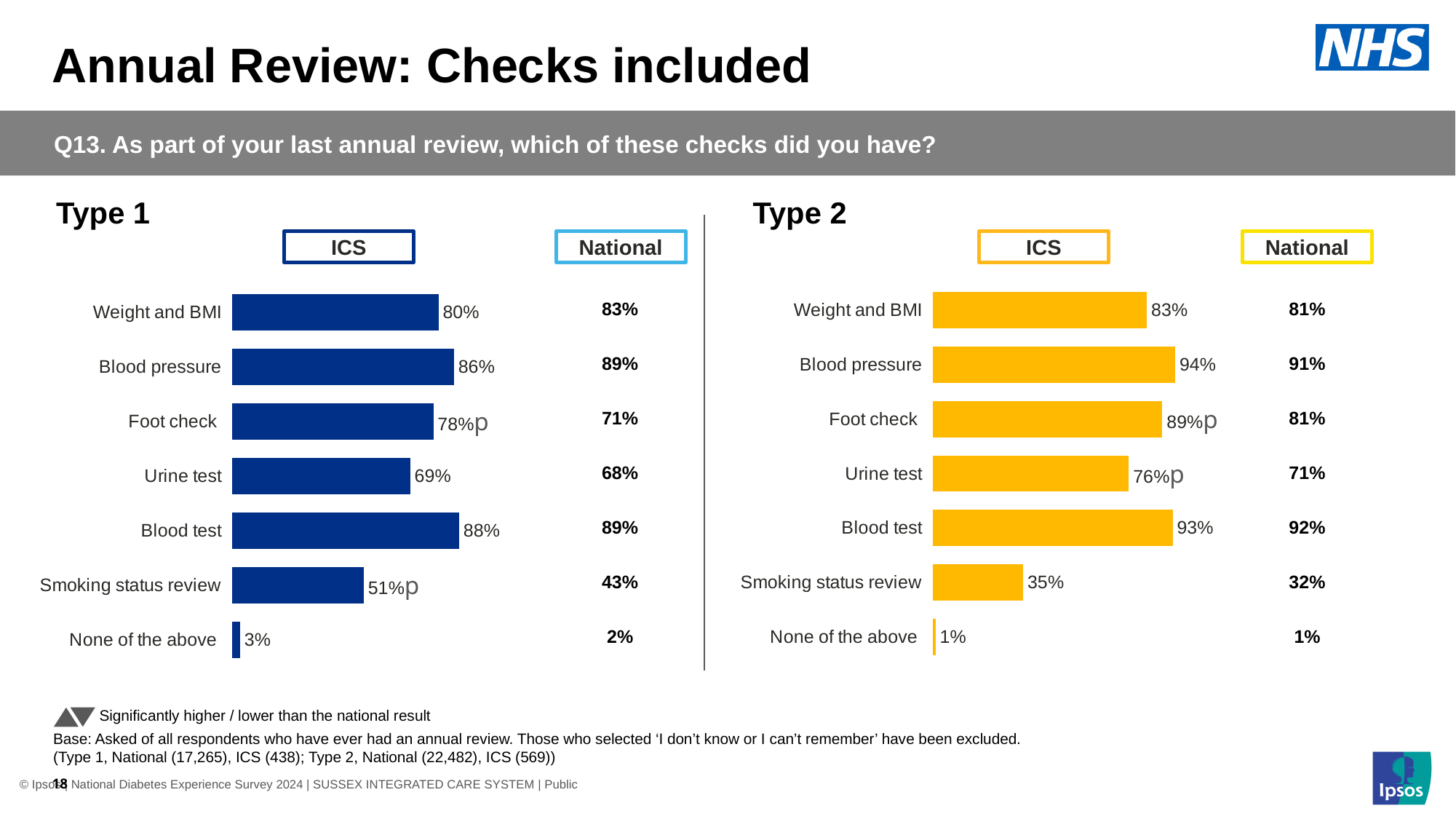
In the Type 2 chart, what is the ICS value for Foot check? 89% In the Type 1 chart, what is the difference between the ICS and National values for Smoking status review? 8 percentage points In the Type 1 chart, what is the ICS value for Blood pressure? 86% In the Type 1 chart, which category has the lowest ICS value? None of the above What colour are the ICS bars in the Type 2 chart? Yellow In the Type 2 chart, which check has the highest ICS value? Blood pressure In the Type 1 chart, what is the National value for Smoking status review? 43% How many checks (categories) are listed in the Type 1 chart? 7 In the Type 1 chart, is the ICS value for Foot check larger or smaller than the National value? larger What type of chart is used to show the ICS results for Type 2? Bar chart In the Type 2 chart, what is the difference between the ICS and National values for Urine test? 5 percentage points In the Type 2 chart, which is larger for Weight and BMI: the ICS value or the National value? ICS